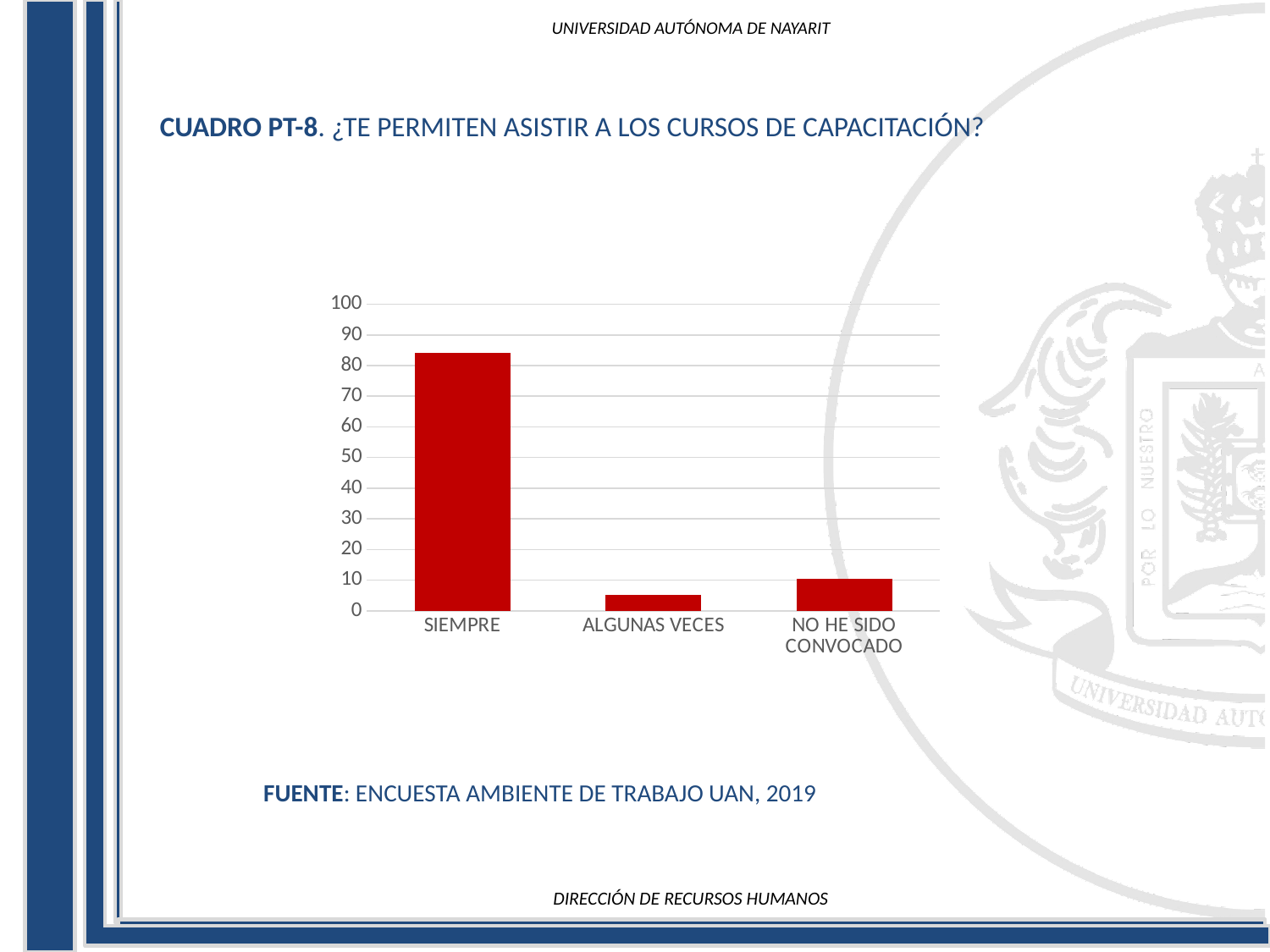
What kind of chart is shown on the slide? bar chart What is the title of the chart on the slide? CUADRO PT-8. ¿TE PERMITEN ASISTIR A LOS CURSOS DE CAPACITACIÓN? Is the value for NO HE SIDO CONVOCADO greater or less than 20? less What colour are the bars in the chart? red Is the value for SIEMPRE greater or less than 90? less Is the value for SIEMPRE greater or less than 70? greater Which category has the lowest value in the chart? ALGUNAS VECES Which category has the highest value in the chart? SIEMPRE How many categories are shown on the x axis of the chart? 3 Which is larger, the value for NO HE SIDO CONVOCADO or the value for ALGUNAS VECES? NO HE SIDO CONVOCADO Which is larger, the value for SIEMPRE or the value for NO HE SIDO CONVOCADO? SIEMPRE